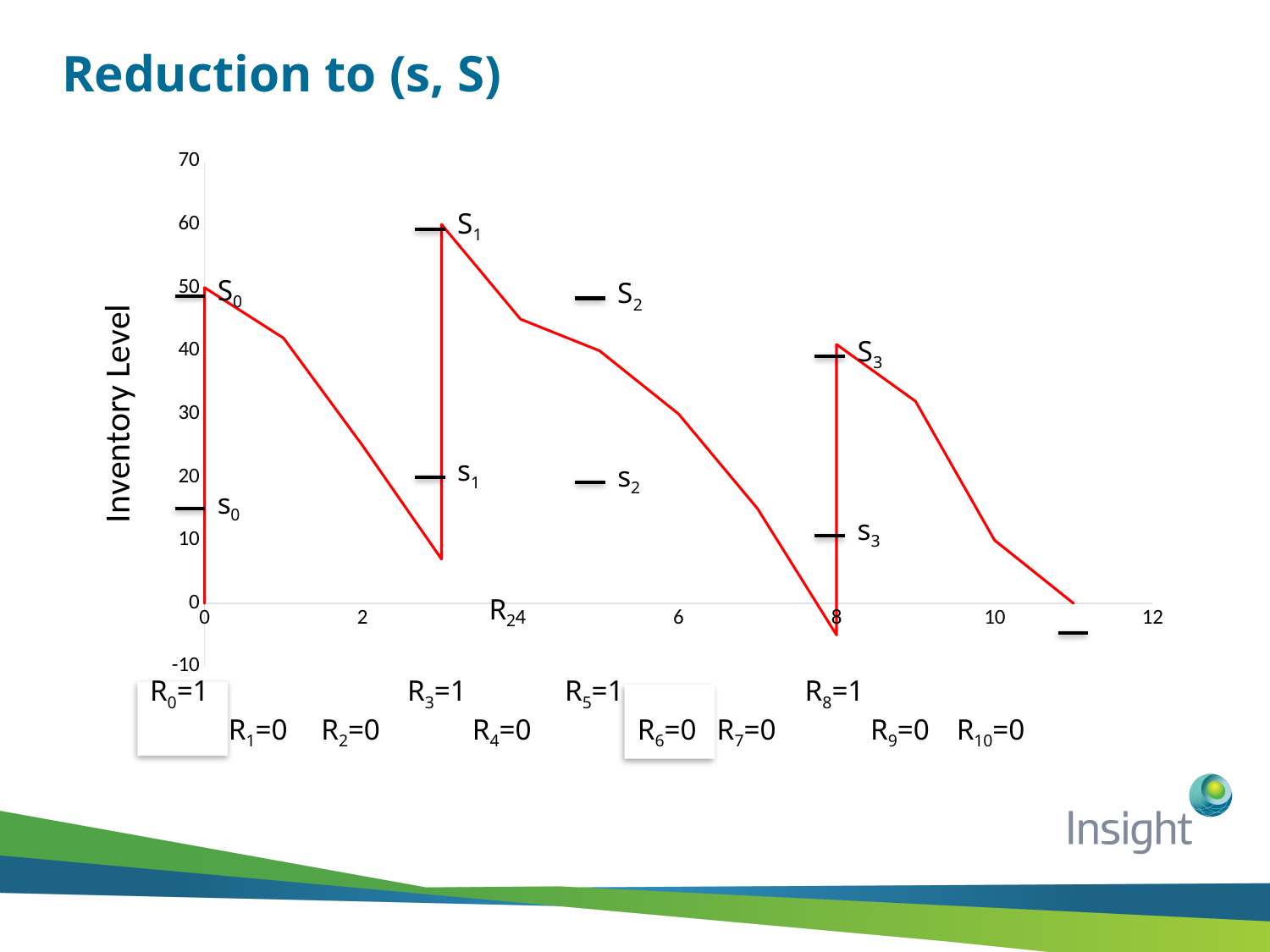
Is the inventory level at x = 5 greater or less than 30? greater What is the title of the vertical axis? Inventory Level What kind of chart is shown on the slide? line chart Is the inventory level immediately after the replenishment at x = 3 greater or less than 50? greater Between x = 3 and x = 8, does the inventory level rise or fall? fall Is the inventory level at x = 9 greater or less than 20? greater What colour is the plotted inventory line? red At which x value does the inventory line reach its lowest point? 8 At which x value does the inventory line reach its highest point? 3